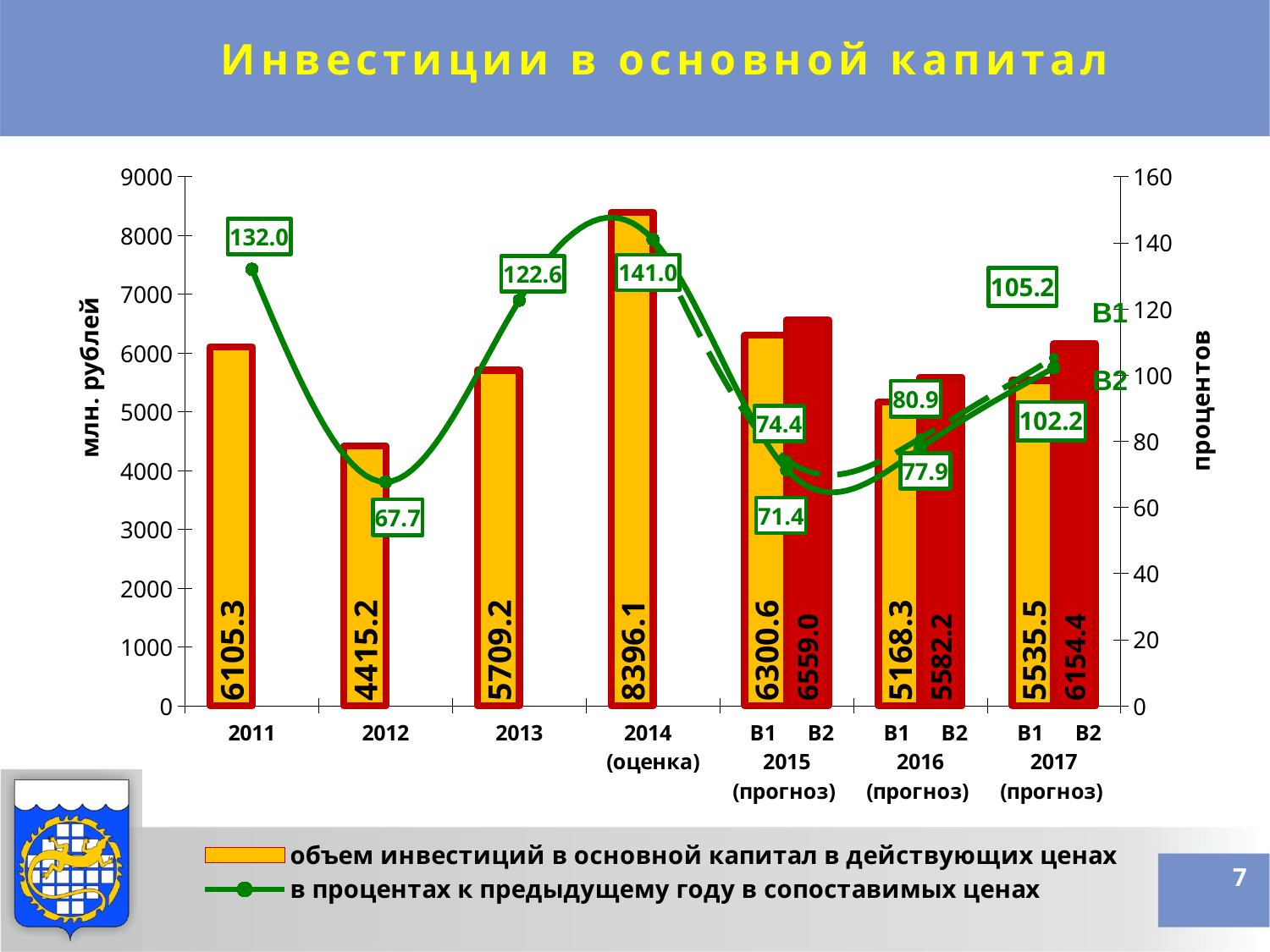
Which year has the highest investment volume in current prices? 2014 (оценка) What is the percent-to-previous-year value for 2012? 67.7 What is the difference between the В2 and В1 investment volumes in 2017 (прогноз)? 618.9 What is the investment volume in current prices for 2011? 6105.3 What is the percent-to-previous-year value for 2013? 122.6 How many bars are plotted on the chart? 10 What is the title of the chart on the slide? Инвестиции в основной капитал Which year has the lowest investment volume in current prices? 2012 What is the investment volume in current prices for 2014 (оценка)? 8396.1 What is the investment volume for variant В2 in 2015 (прогноз)? 6559.0 Which is larger, the investment volume for 2013 or for 2011? 2011 How many series does the legend list? 2